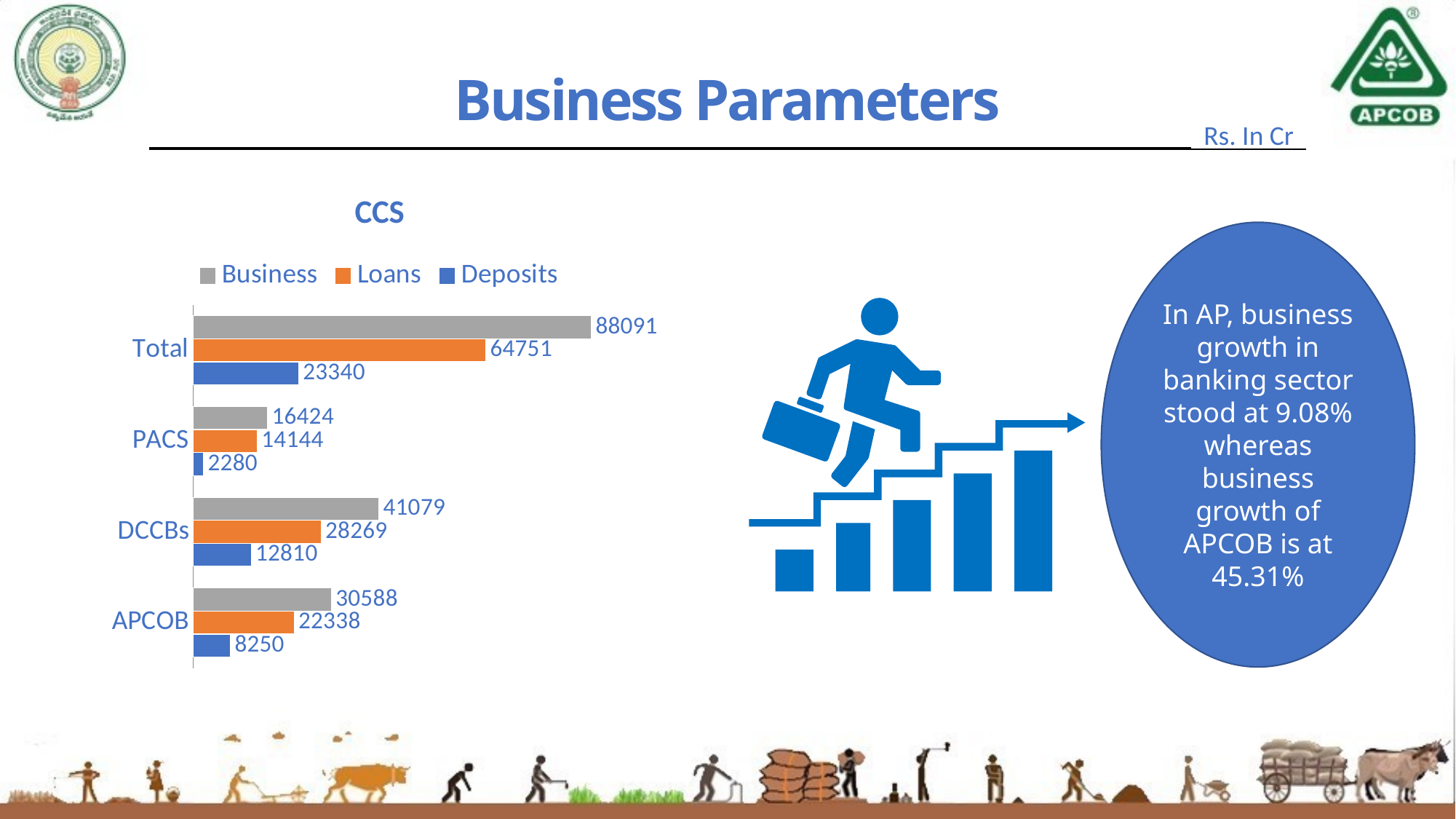
Which is larger in the CCS chart: the Deposits value for DCCBs or the Deposits value for APCOB? DCCBs What is the Loans value for PACS in the CCS chart? 14144 What is the difference between the Business values for DCCBs and APCOB in the CCS chart? 10491 How many categories are shown on the y axis of the CCS chart? 4 What is the Loans value for DCCBs in the CCS chart? 28269 What is the Business value for Total in the CCS chart? 88091 What type of chart is the CCS chart? Bar chart How many series does the legend of the CCS chart list? 3 Excluding Total, which category has the highest Business value in the CCS chart? DCCBs Which category has the lowest Deposits value in the CCS chart? PACS What is the Deposits value for APCOB in the CCS chart? 8250 What is the difference between the Loans and Deposits values for Total in the CCS chart? 41411